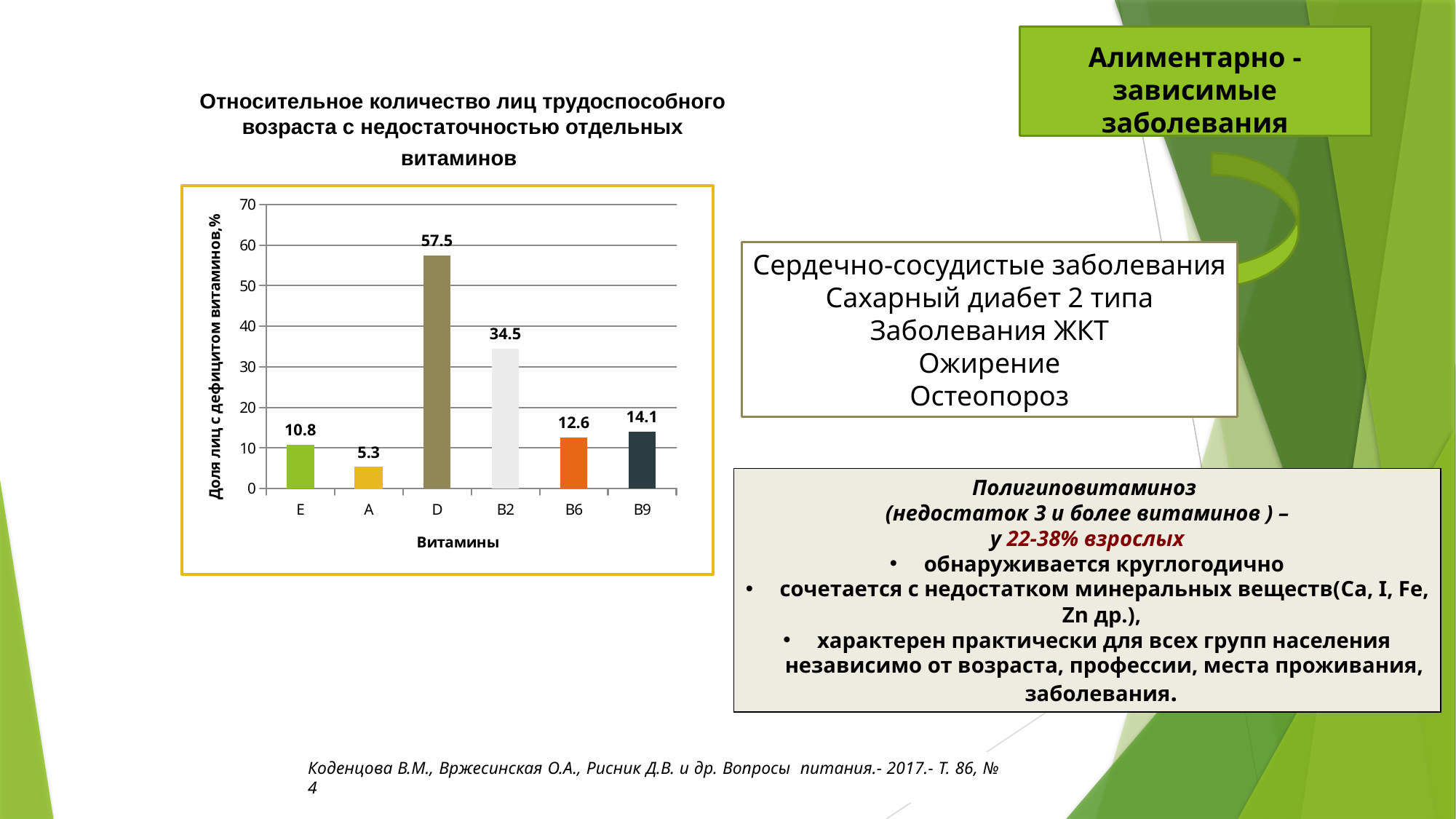
How many vitamins are shown on the x axis? 6 Which is larger, the value for vitamin E or the value for vitamin B6? B6 What is the value for vitamin B2? 34.5 What is the label of the y axis of the chart? Доля лиц с дефицитом витаминов,% Which vitamin has the lowest share of people with deficiency? A What kind of chart is shown on the slide? bar chart Which vitamin has the highest share of people with deficiency? D Is the value for vitamin B2 greater or less than 30? greater What is the value for vitamin D? 57.5 What is the difference between the values for vitamin B9 and vitamin B6? 1.5 What is the difference between the values for vitamin D and vitamin B2? 23 What is the value for vitamin A? 5.3